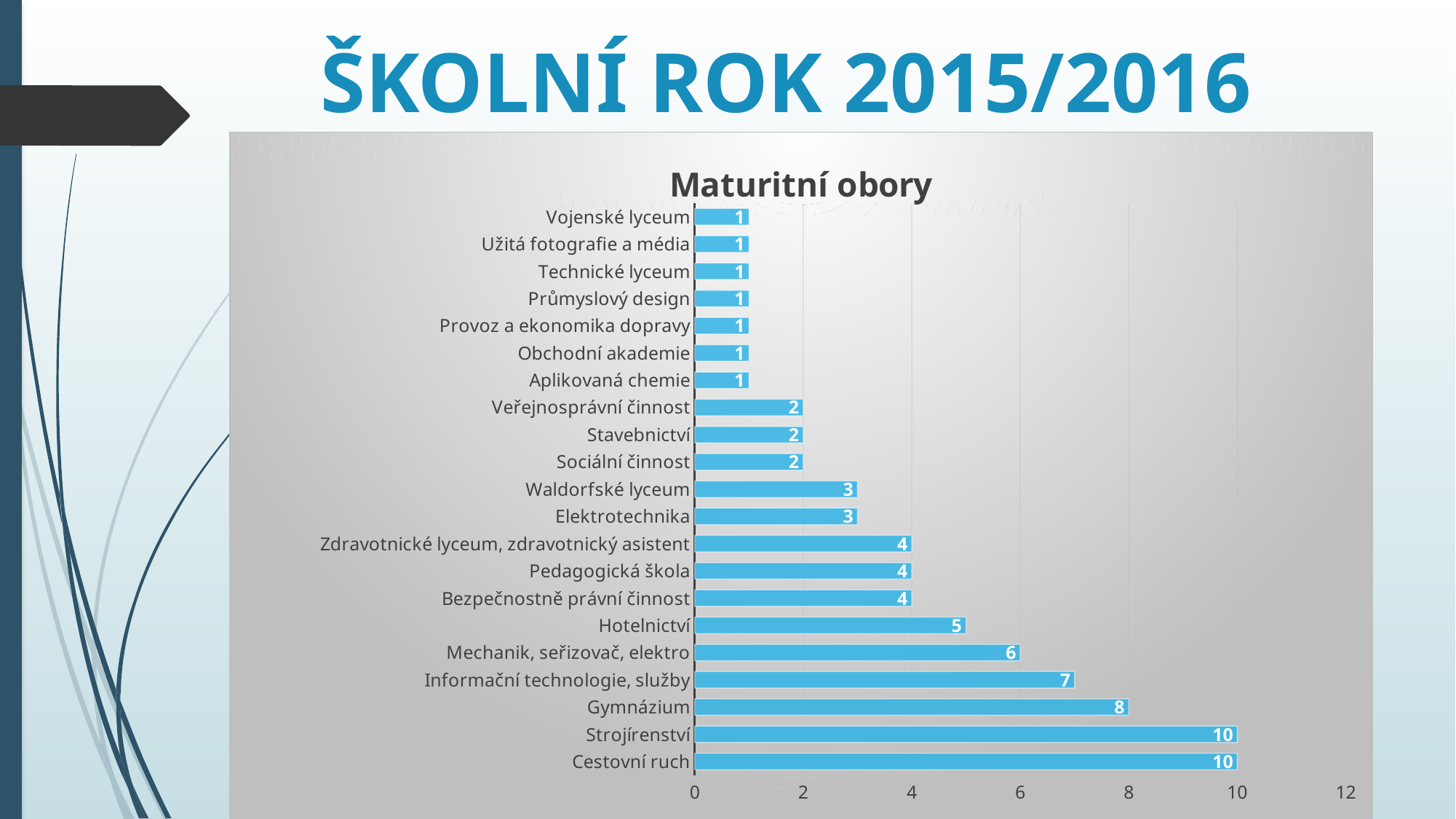
What is the value for Gymnázium? 8 What is the difference between the values for Cestovní ruch and Gymnázium? 2 What is the difference between the values for Mechanik, seřizovač, elektro and Stavebnictví? 4 How many categories are shown in the chart? 21 What is the value for Hotelnictví? 5 What kind of chart is shown on the slide? bar chart What is the value for Informační technologie, služby? 7 What is the value for Strojírenství? 10 What is the title of the chart? Maturitní obory Which is larger, the value for Hotelnictví or the value for Waldorfské lyceum? Hotelnictví What is the value for Elektrotechnika? 3 Which is larger, the value for Pedagogická škola or the value for Sociální činnost? Pedagogická škola